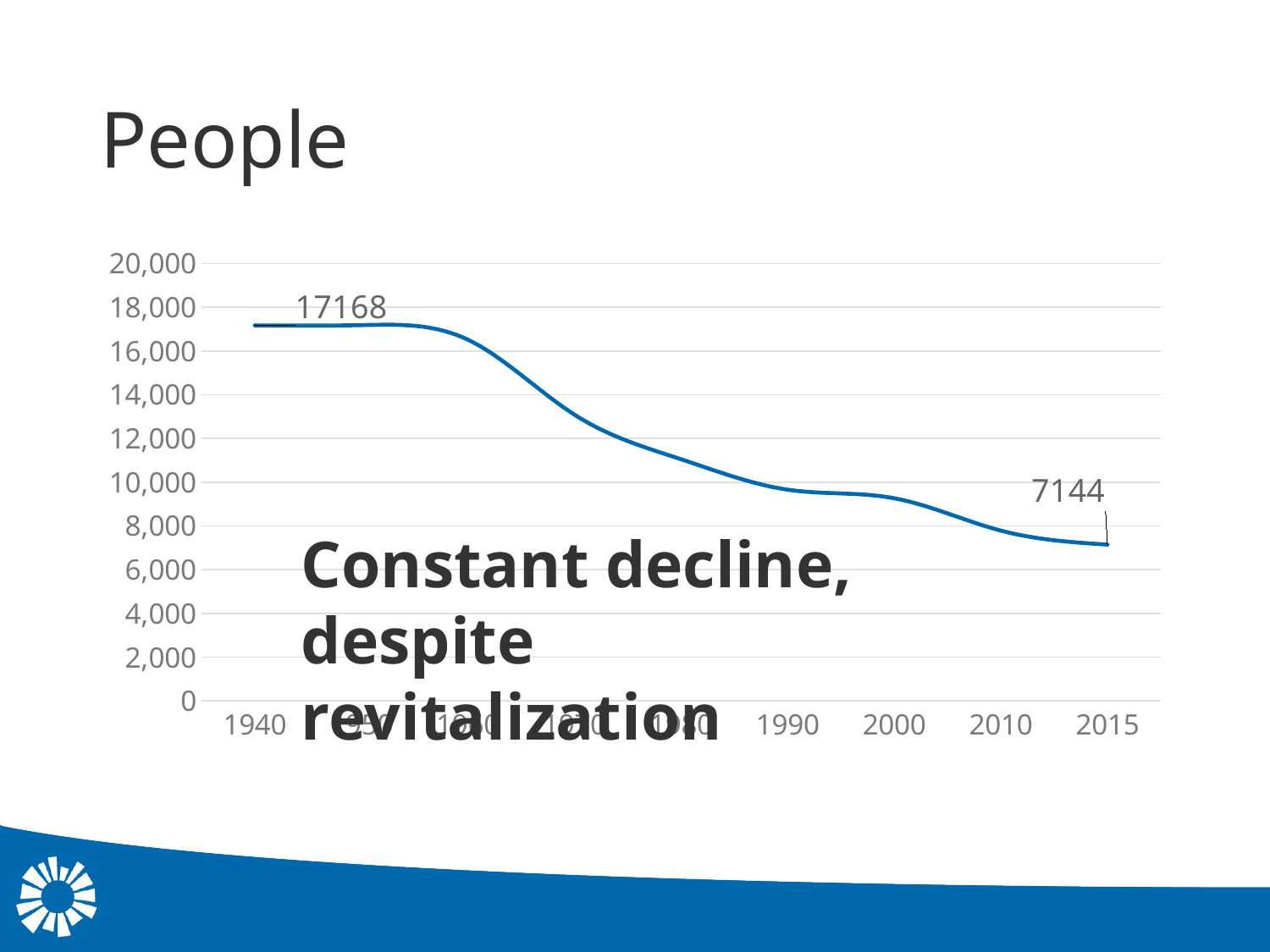
Which year has the lowest value on the chart? 2015 What is the title of the slide containing the chart? People Which is larger, the value for 1940 or the value for 2015? 1940 What is the value plotted for 2015? 7144 Do the values rise or fall from 1940 to 2015? fall What is the value plotted for 1940? 17168 What text is overlaid on the chart in bold? Constant decline, despite revitalization Is the value for 2000 greater or less than 10,000? less What kind of chart is shown on the slide? line chart What is the difference between the 1940 value and the 2015 value? 10024 Is the value for 2010 greater or less than 6,000? greater